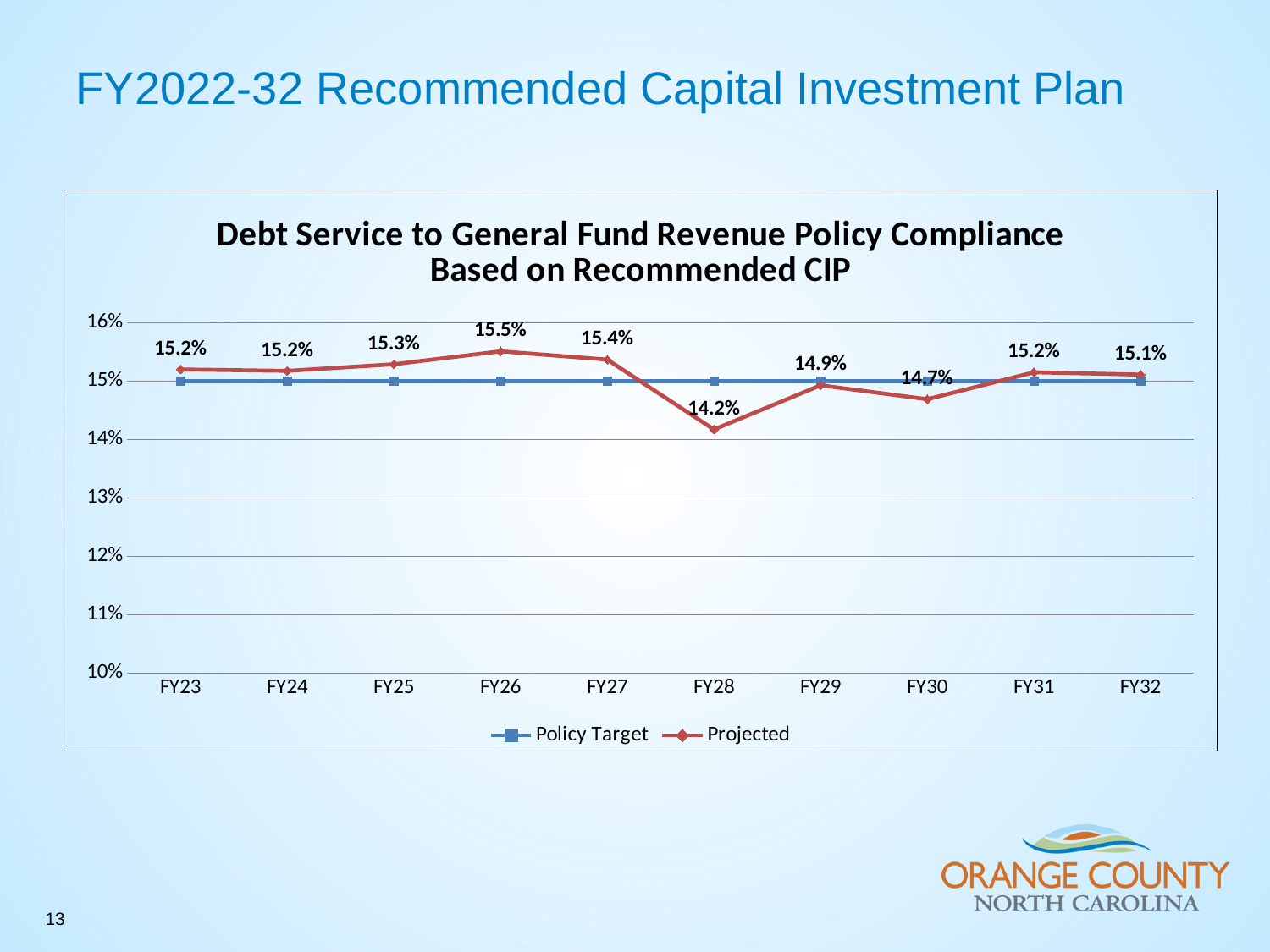
How many series does the legend list? 2 What is the Projected value for FY28? 14.2% What is the title of the chart? Debt Service to General Fund Revenue Policy Compliance Based on Recommended CIP Which is larger, the Projected value for FY27 or for FY29? FY27 What is the Projected value for FY30? 14.7% What is the difference between the Projected values for FY26 and FY28? 1.3% What kind of chart is shown? line chart In which fiscal year is the Projected value highest? FY26 How many fiscal years are shown on the x axis? 10 In which fiscal year is the Projected value lowest? FY28 What is the Projected value for FY26? 15.5% Is the Projected value for FY28 greater or less than 15%? less